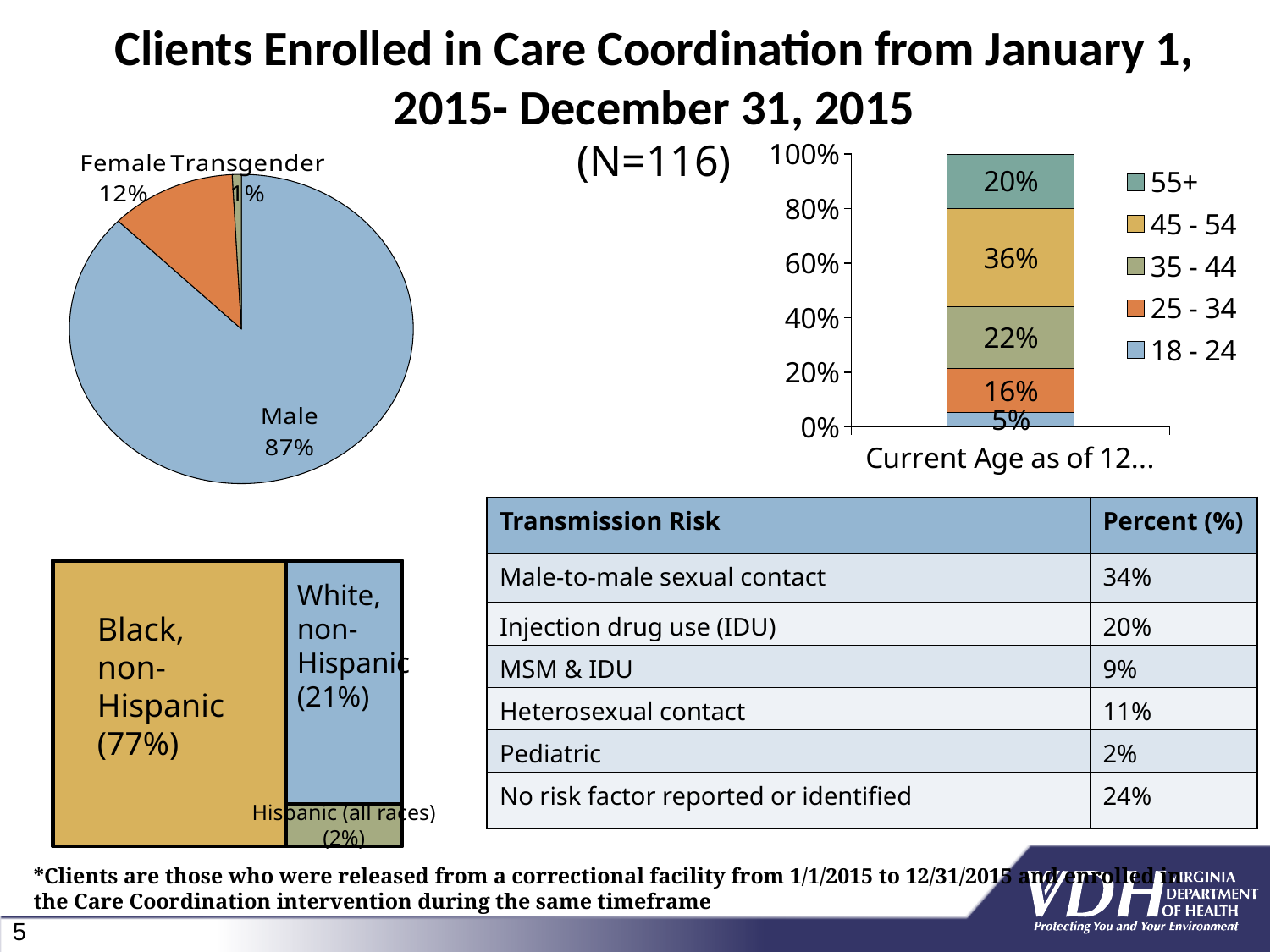
In the pie chart on the left, what share of clients are Female? 12% In the pie chart on the left, how many categories are shown? 3 In the pie chart on the left, what share of clients are Male? 87% In the pie chart on the left, which category has the smallest slice? Transgender In the race/ethnicity chart at the bottom left, what percentage of clients are Black, non-Hispanic? 77% In the pie chart on the left, what is the difference between the Male and Female shares? 75% In the stacked bar chart of current age, which age group has the largest share? 45 - 54 In the stacked bar chart of current age, which is larger: the share aged 55+ or the share aged 25 - 34? 55+ In the stacked bar chart of current age, what percentage of clients are aged 45 - 54? 36% In the race/ethnicity chart at the bottom left, what is the difference between the Black, non-Hispanic and White, non-Hispanic shares? 56% In the stacked bar chart of current age, how many age groups does the legend list? 5 In the stacked bar chart of current age, what percentage of clients are aged 18 - 24? 5%